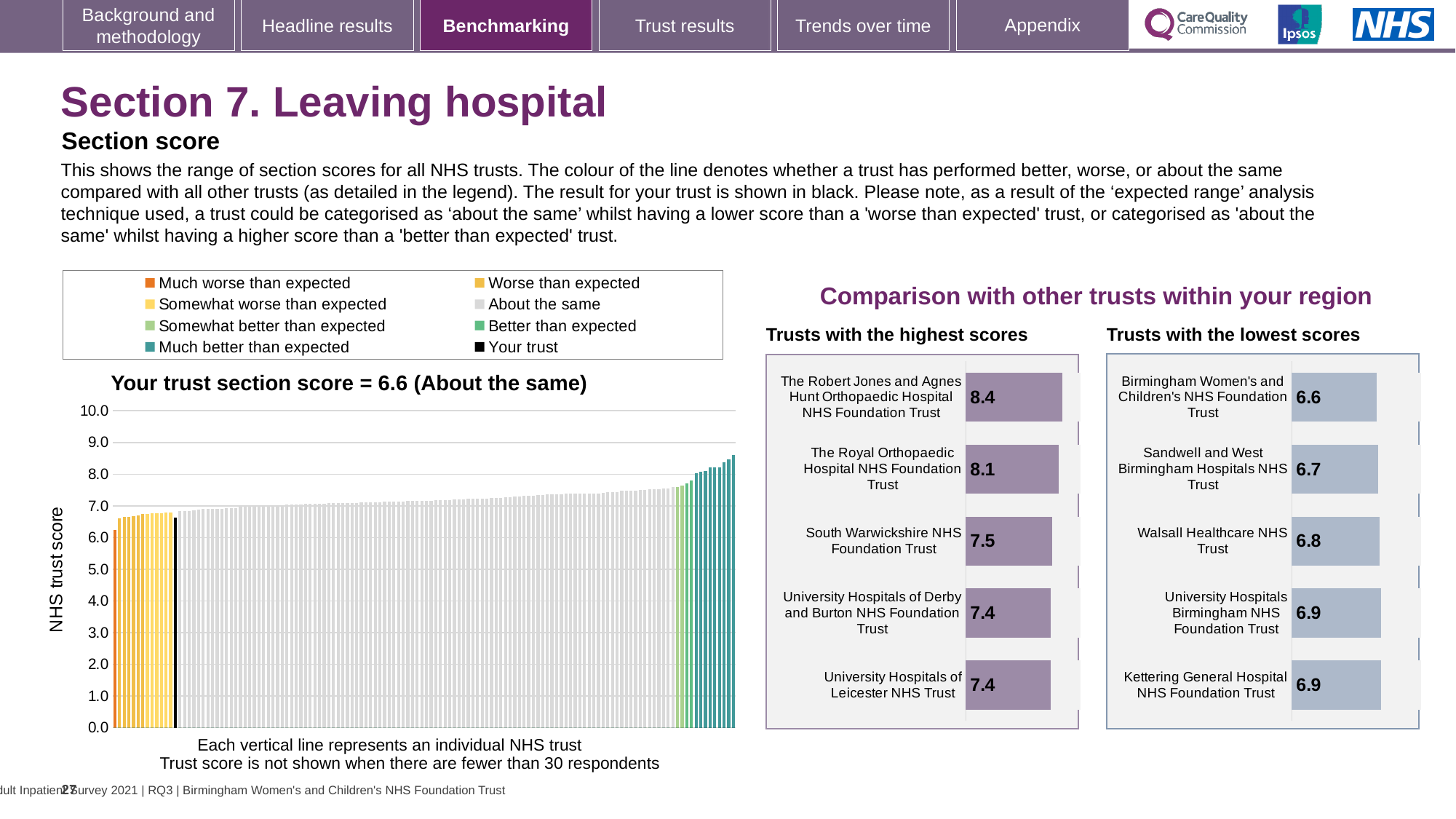
What kind of chart is the 'Your trust section score' chart on the left of the slide? Bar chart On the 'Your trust section score' chart on the left, is the value of the black bar (your trust) greater or less than 7.0? less On the 'Trusts with the lowest scores' chart, what is the score for Walsall Healthcare NHS Trust? 6.8 On the 'Trusts with the highest scores' chart, what is the difference between the scores of The Robert Jones and Agnes Hunt Orthopaedic Hospital NHS Foundation Trust and The Royal Orthopaedic Hospital NHS Foundation Trust? 0.3 How many trusts are shown on the 'Trusts with the highest scores' chart? 5 On the 'Trusts with the lowest scores' chart, which trust has the lowest score? Birmingham Women's and Children's NHS Foundation Trust On the 'Trusts with the lowest scores' chart, which has the higher score: Sandwell and West Birmingham Hospitals NHS Trust or Kettering General Hospital NHS Foundation Trust? Kettering General Hospital NHS Foundation Trust On the 'Your trust section score' chart on the left, do the bar values rise or fall from left to right? Rise On the 'Trusts with the lowest scores' chart, what is the difference between the scores of Walsall Healthcare NHS Trust and Birmingham Women's and Children's NHS Foundation Trust? 0.2 On the 'Trusts with the highest scores' chart, what is the score for South Warwickshire NHS Foundation Trust? 7.5 On the 'Trusts with the highest scores' chart, what is the score for The Robert Jones and Agnes Hunt Orthopaedic Hospital NHS Foundation Trust? 8.4 On the 'Trusts with the highest scores' chart, which trust has the highest score? The Robert Jones and Agnes Hunt Orthopaedic Hospital NHS Foundation Trust